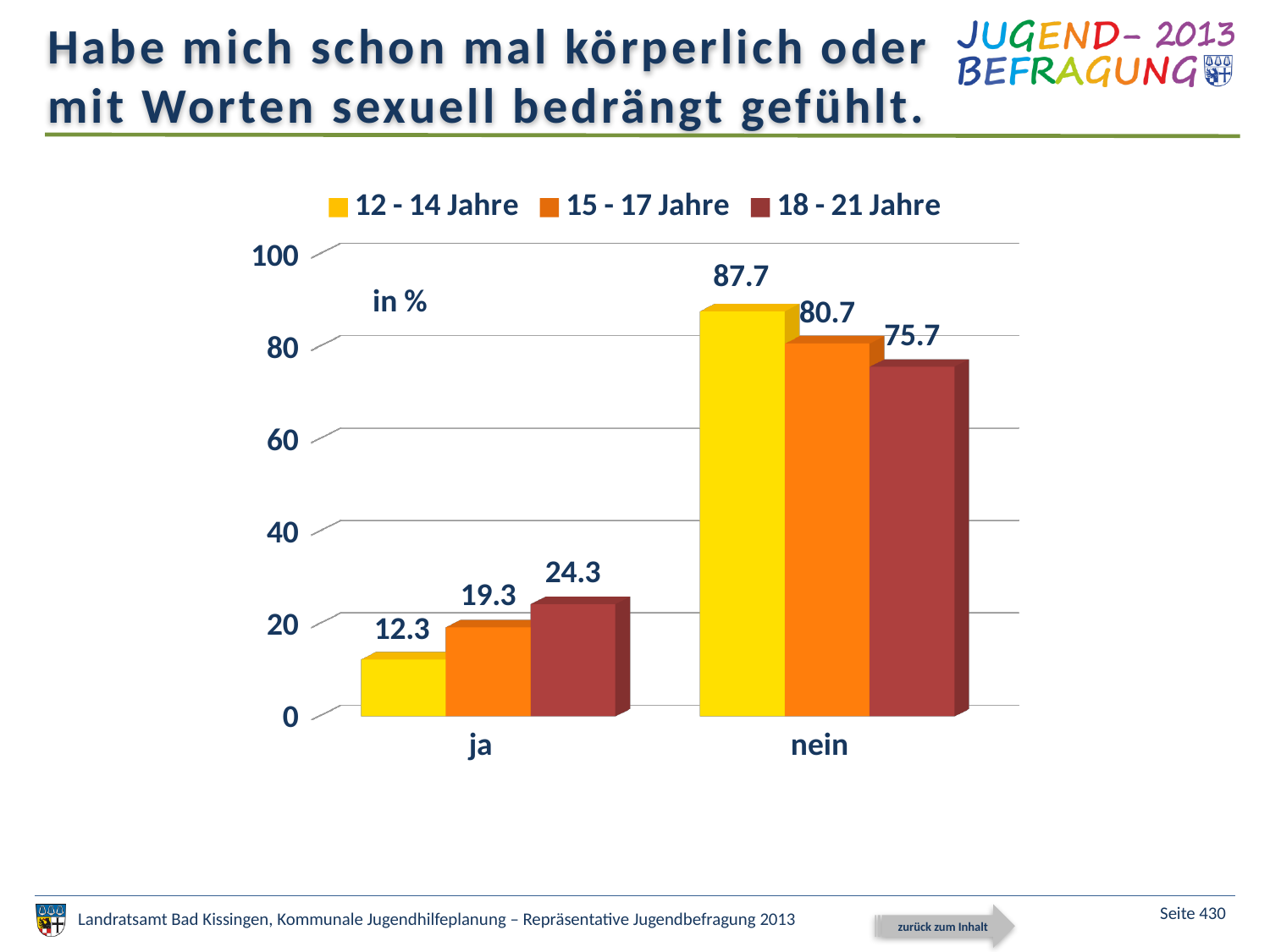
What is the value for the 15 - 17 Jahre series in the "ja" category? 19.3 Is the value for 15 - 17 Jahre in the "nein" category greater or less than 80? greater Which age group has the lowest value in the "nein" category? 18 - 21 Jahre What is the difference between the 18 - 21 Jahre and 12 - 14 Jahre values in the "ja" category? 12 What kind of chart is shown on the slide? bar chart Which is larger: the 15 - 17 Jahre value for "ja" or the 12 - 14 Jahre value for "ja"? 15 - 17 Jahre Which age group has the highest value in the "ja" category? 18 - 21 Jahre What is the value for the 18 - 21 Jahre series in the "nein" category? 75.7 How many series does the legend list? 3 What is the difference between the 12 - 14 Jahre and 18 - 21 Jahre values in the "nein" category? 12 How many categories are shown on the x axis? 2 What is the value for the 12 - 14 Jahre series in the "ja" category? 12.3